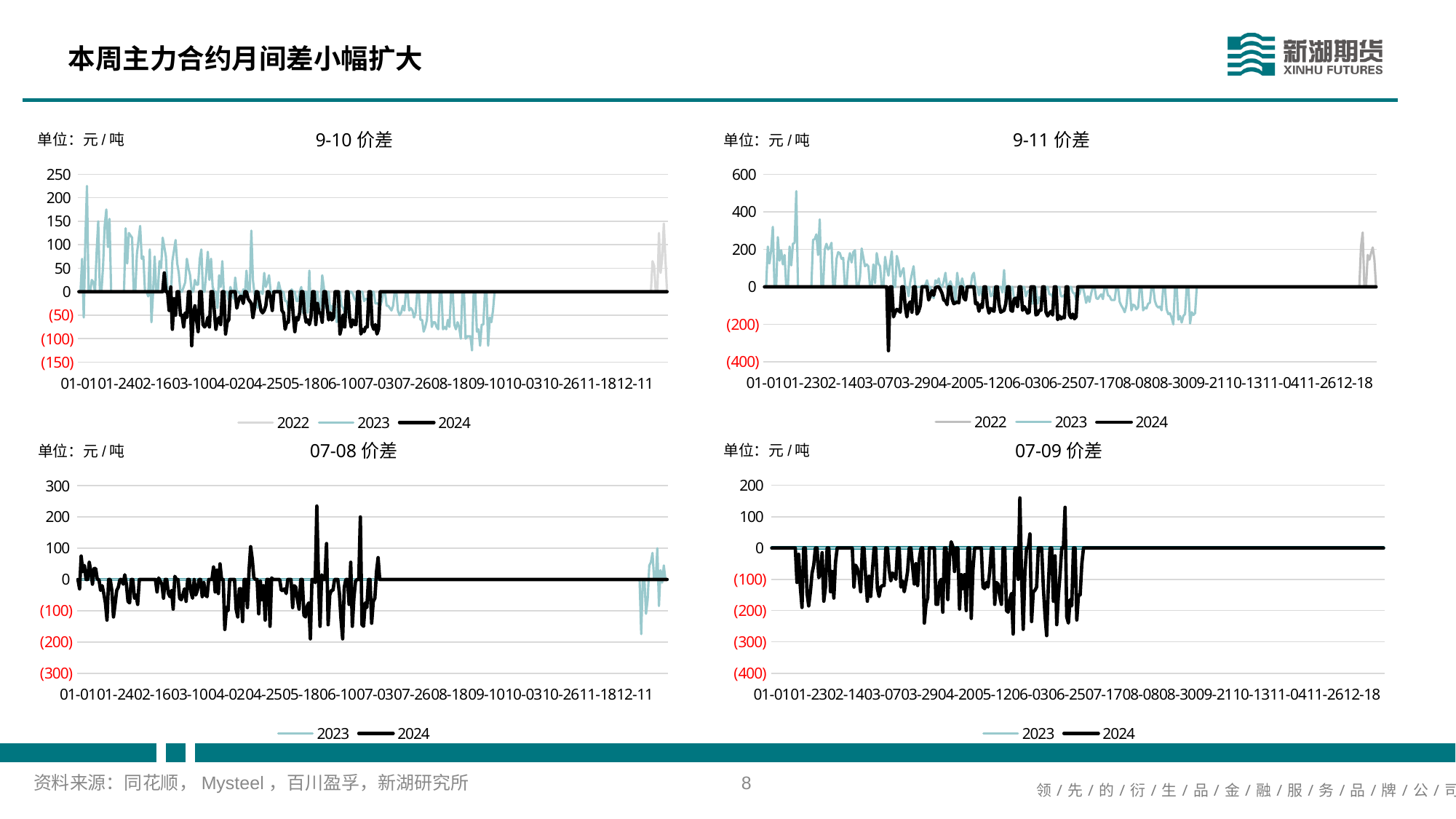
How many series does the legend of the "9-10 价差" chart list? 3 What kind of chart is the "9-10 价差" chart? line chart In the "9-11 价差" chart, which series reaches the higher peak, 2023 or 2024? 2023 In the "9-10 价差" chart, is the highest value of the 2023 series greater or less than 150? greater In the "07-08 价差" chart, is the highest value of the 2024 series greater or less than 100? greater In the "07-09 价差" chart, is the highest value of the 2024 series greater or less than 100? greater What unit is shown for the values in the "07-09 价差" chart? 元/吨 How many charts are shown on the slide? 4 How many series does the legend of the "07-08 价差" chart list? 2 Which series are listed in the legend of the "9-11 价差" chart? 2022, 2023, 2024